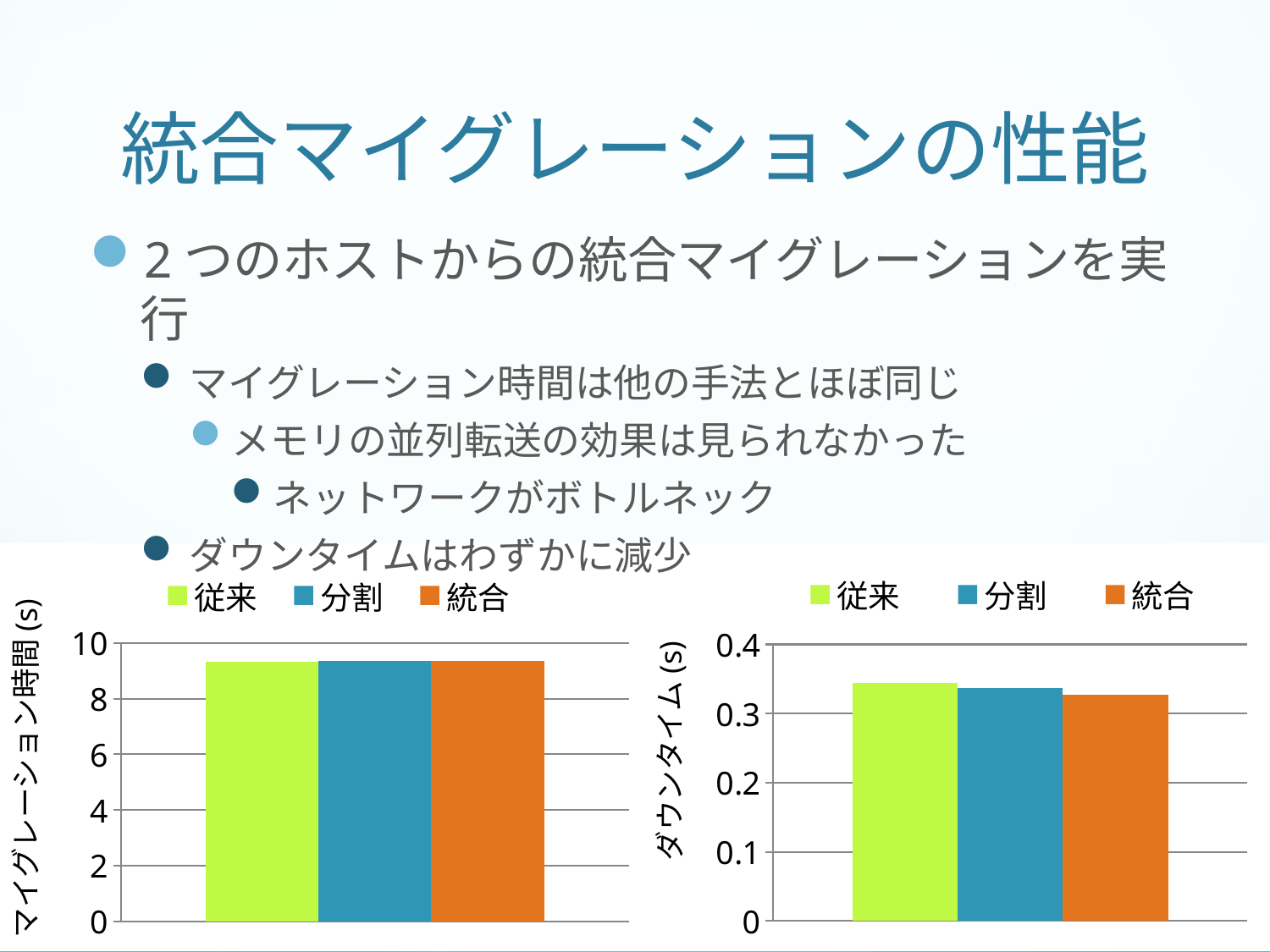
In the left chart (マイグレーション時間), how many series does the legend list? 3 What kind of chart is the right chart (ダウンタイム)? bar chart In the right chart (ダウンタイム), is the value for 統合 greater or less than 0.4? less In the right chart (ダウンタイム), how many bars are plotted? 3 In the right chart (ダウンタイム), which is larger, the value for 従来 or the value for 統合? 従来 In the left chart (マイグレーション時間), what colour is the 統合 series? orange In the left chart (マイグレーション時間), is the value for 統合 greater or less than 10? less In the left chart (マイグレーション時間), is the value for 従来 greater or less than 8? greater What is the y-axis label of the right chart? ダウンタイム (s) In the right chart (ダウンタイム), do the values rise or fall from 従来 to 統合? fall What kind of chart is the left chart (マイグレーション時間)? bar chart